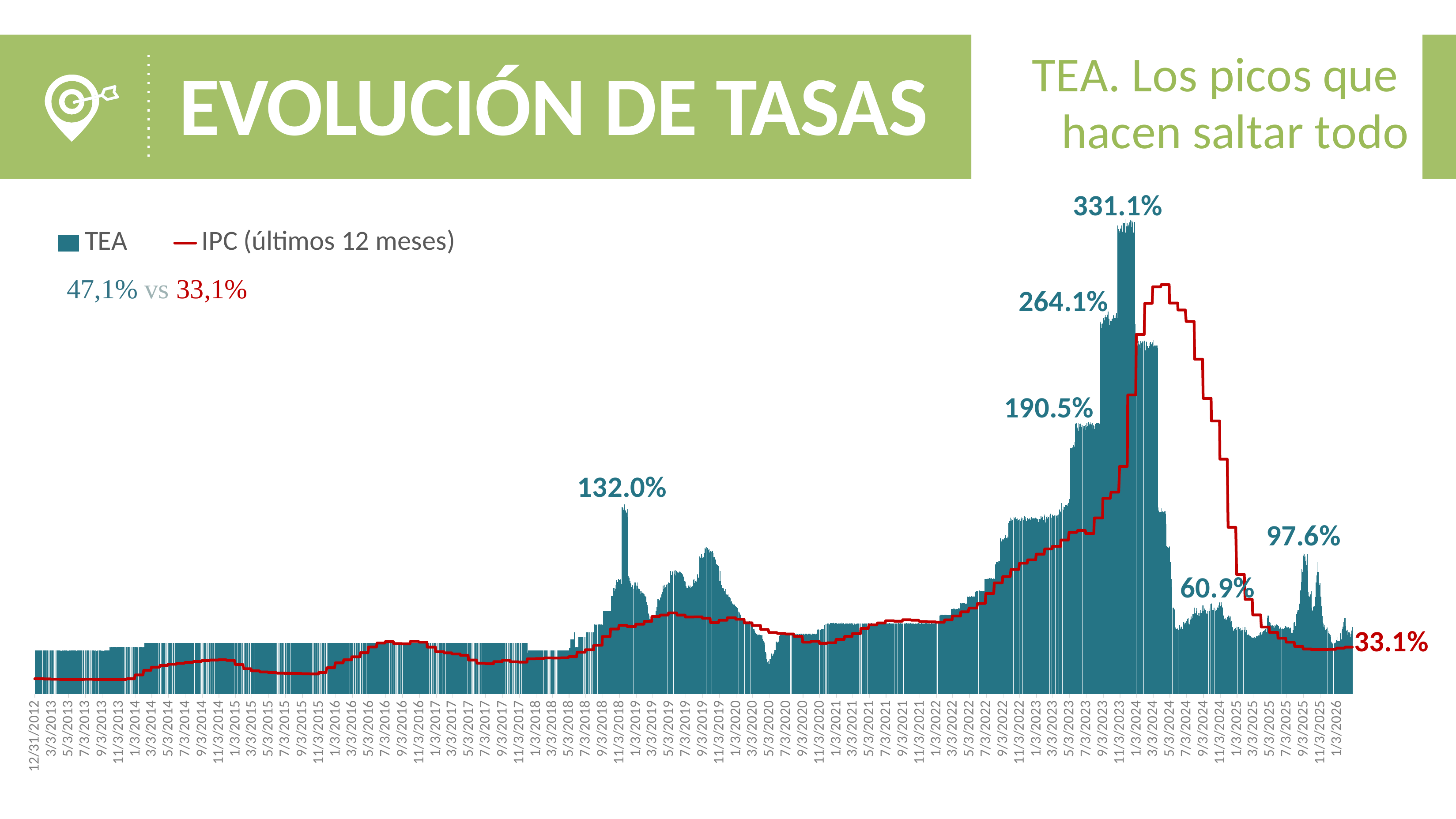
What TEA value is labelled at the spike around late 2018? 132.0% What TEA value is labelled at the peak in late 2025? 97.6% What is the lowest TEA value labelled on the chart? 60.9% What is the difference between the labelled TEA values of 97.6% and 60.9%? 36.7 percentage points How many series does the legend list? 2 What is the difference between the labelled TEA peaks of 331.1% and 264.1%? 67.0 percentage points Does the IPC line rise or fall between early 2024 and early 2026? fall What are the two legend entries of the chart? TEA and IPC (últimos 12 meses) Which labelled TEA value is larger, 190.5% or 132.0%? 190.5% How many TEA data labels are printed on the chart? 6 What is the highest TEA value labelled on the chart? 331.1% What is the final IPC (últimos 12 meses) value labelled at the right end of the red line? 33.1%